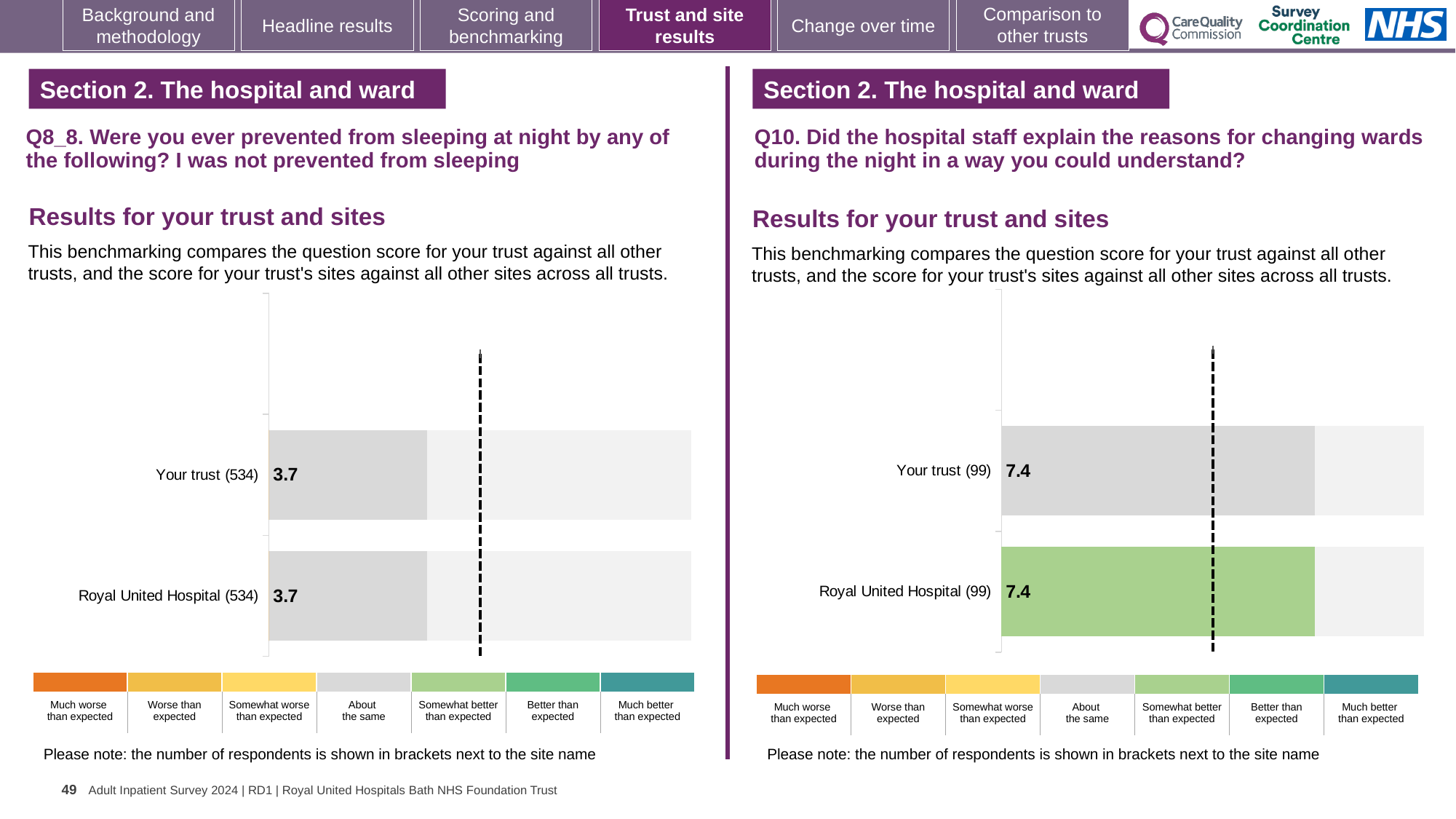
What kind of chart is used in the left chart (Q8_8)? Bar chart In the right chart (Q10), what is the score for Royal United Hospital? 7.4 In the left chart (Q8_8), what is the difference between the score for Your trust and the score for Royal United Hospital? 0 In the left chart (Q8_8), what is the score for Royal United Hospital? 3.7 In the left chart (Q8_8), how many respondents are shown in brackets next to Your trust? 534 In the right chart (Q10), what is the difference between the score for Your trust and the score for Royal United Hospital? 0 In the right chart (Q10), which benchmark category does the green colour of the Royal United Hospital bar correspond to in the legend? Somewhat better than expected How many bars are plotted in the left chart (Q8_8)? 2 In the left chart (Q8_8), what is the score for Your trust? 3.7 In the right chart (Q10), what is the score for Your trust? 7.4 In the right chart (Q10), how many respondents are shown in brackets next to Royal United Hospital? 99 How many bars are plotted in the right chart (Q10)? 2